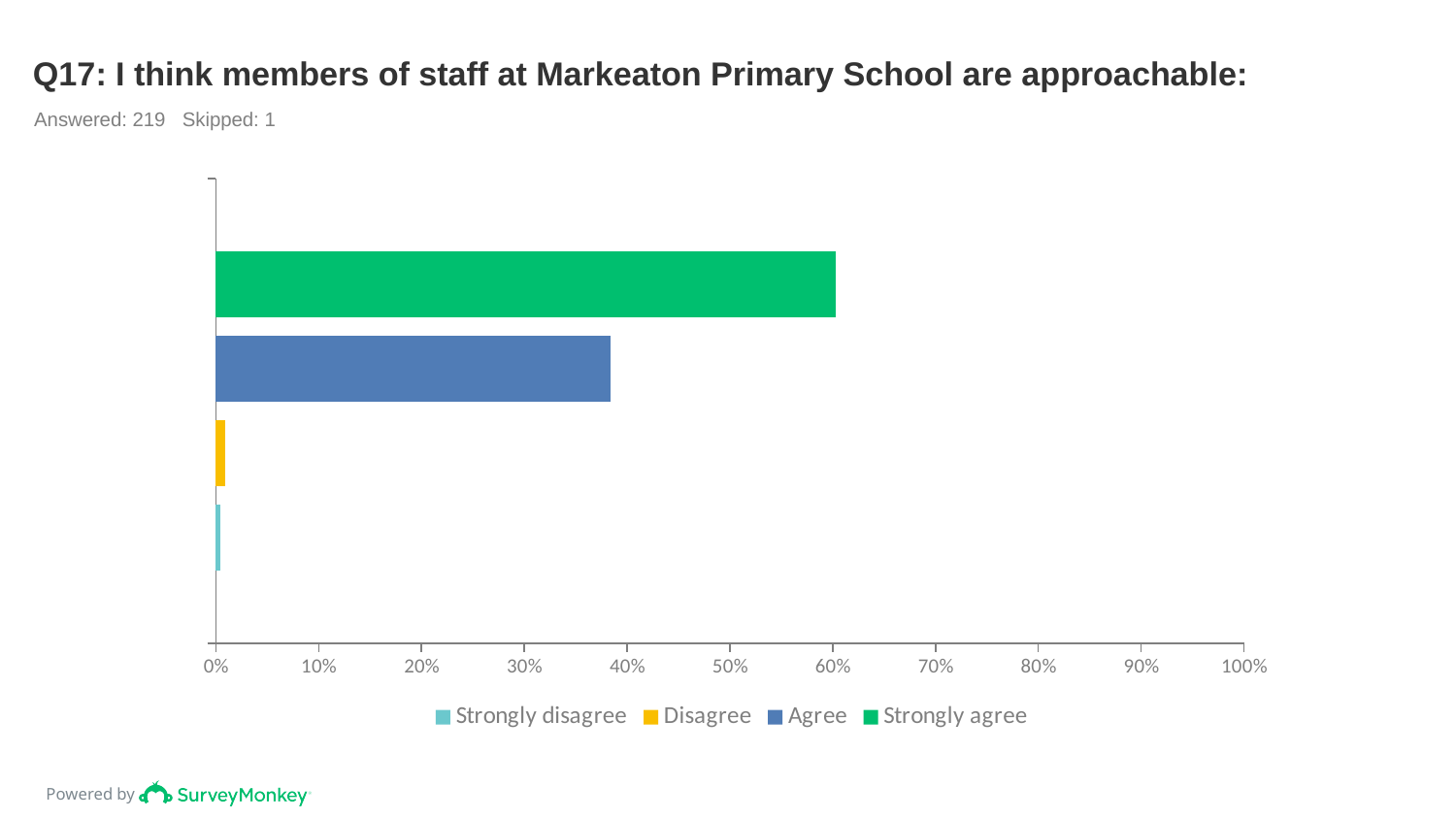
What kind of chart is shown on the slide? bar chart Is the value for Strongly agree greater or less than 70%? less Which is larger, the value for Agree or the value for Disagree? Agree Is the value for Disagree greater or less than 10%? less Which colour represents Strongly agree in the legend? green Which response option has the highest value? Strongly agree Which is larger, the value for Strongly agree or the value for Agree? Strongly agree How many series does the legend list? 4 Is the value for Strongly agree greater or less than 50%? greater What is the title of the chart? Q17: I think members of staff at Markeaton Primary School are approachable: